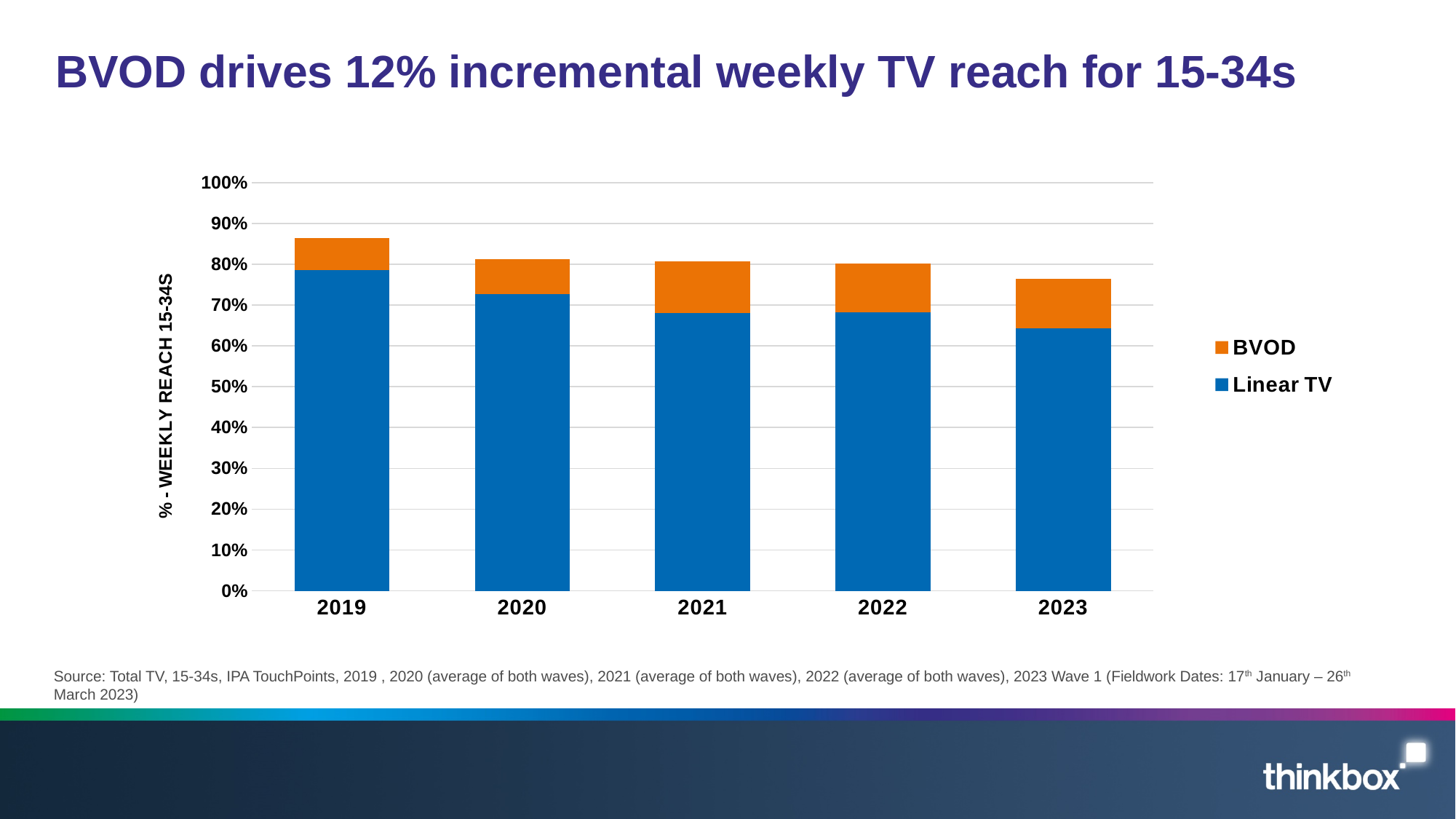
Is the total stacked bar for 2023 greater or less than 80%? less How many series does the chart's legend list? 2 How many years are shown on the x axis of the chart? 5 Which year has the highest total weekly TV reach? 2019 Does the total weekly TV reach rise or fall from 2019 to 2023? Fall Which year has the lowest Linear TV reach? 2023 Which is larger, the Linear TV value for 2019 or for 2023? 2019 What kind of chart is shown on the slide? Stacked bar chart Is the Linear TV value for 2023 greater or less than 70%? less Which year has the lowest total weekly TV reach? 2023 Is the Linear TV value for 2019 greater or less than 70%? greater What is the title of the chart's vertical axis? % - WEEKLY REACH 15-34S